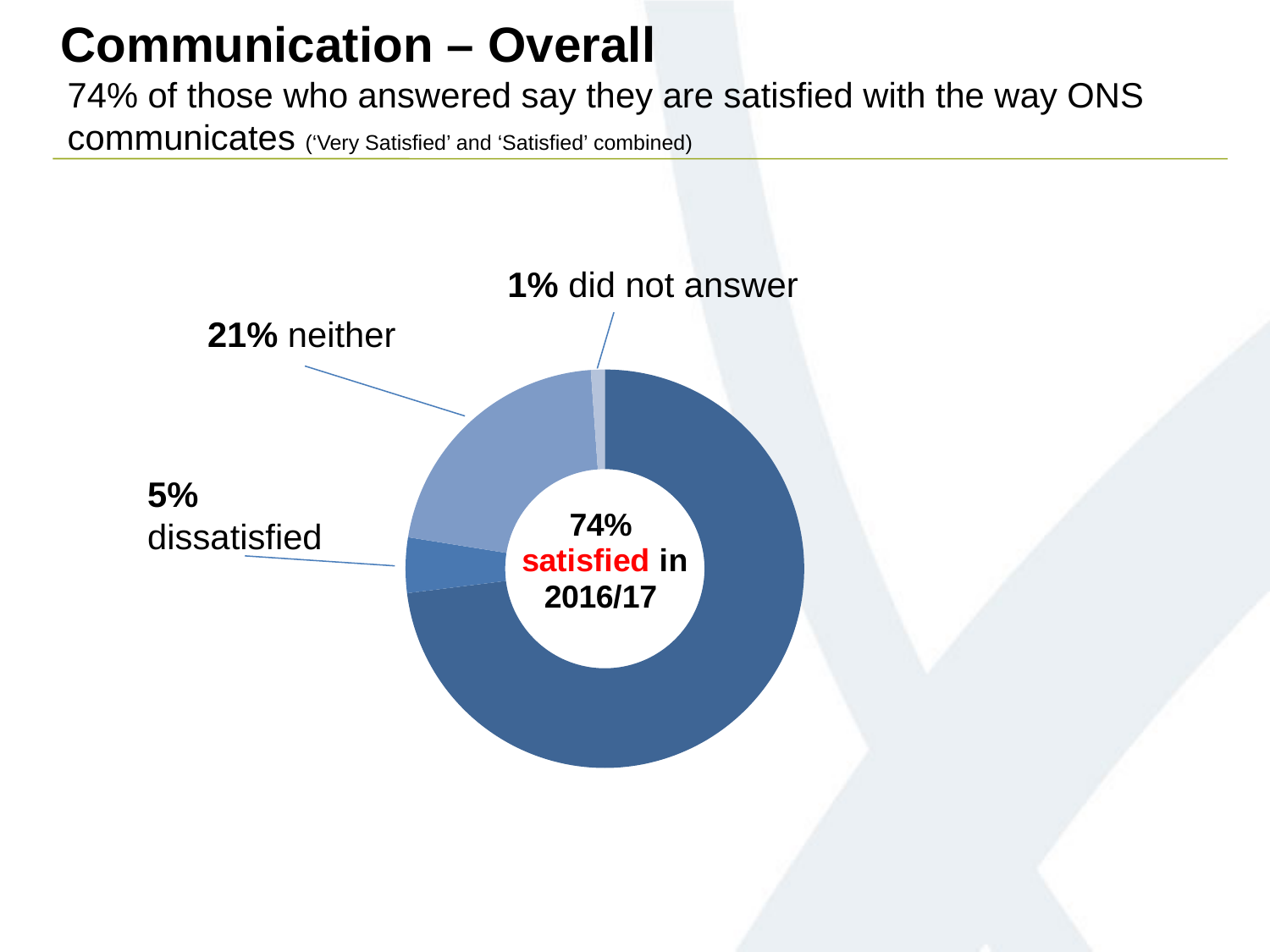
What kind of chart is shown on the slide? doughnut chart What is the difference in percentage points between the 'satisfied' and 'neither' shares? 53 Which year does the chart's centre label refer to? 2016/17 Which is larger, the share for 'neither' or the share for 'dissatisfied'? neither Which category has the largest share of the chart? satisfied How many categories are shown in the chart? 4 What percentage of respondents were dissatisfied? 5% What percentage of respondents were satisfied with the way ONS communicates? 74% Which category has the smallest share of the chart? did not answer What is the difference in percentage points between 'dissatisfied' and 'did not answer'? 4 What percentage of respondents answered 'neither'? 21% What percentage of respondents did not answer? 1%